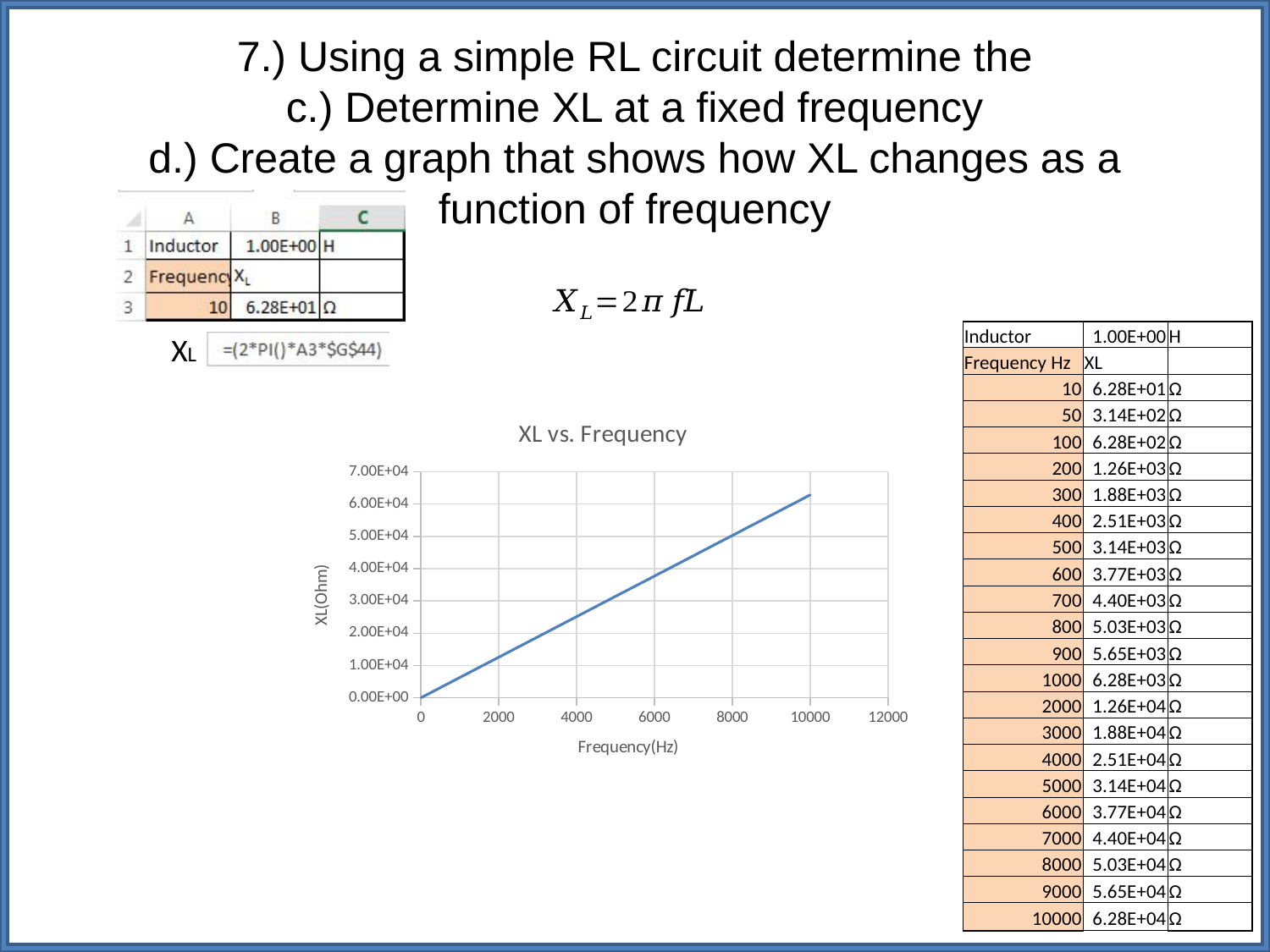
What is the title of the chart? XL vs. Frequency Is the value of XL at 10000 Hz greater or less than 5.00E+04? greater Is the value of XL at 8000 Hz greater or less than 4.00E+04? greater Is the value of XL at 6000 Hz greater or less than 3.00E+04? greater What kind of chart is shown on the slide? line chart What is the label on the vertical axis of the chart? XL(Ohm) At which frequency on the x axis does the line reach its highest XL value? 10000 Does XL rise or fall as frequency increases along the x axis? rises